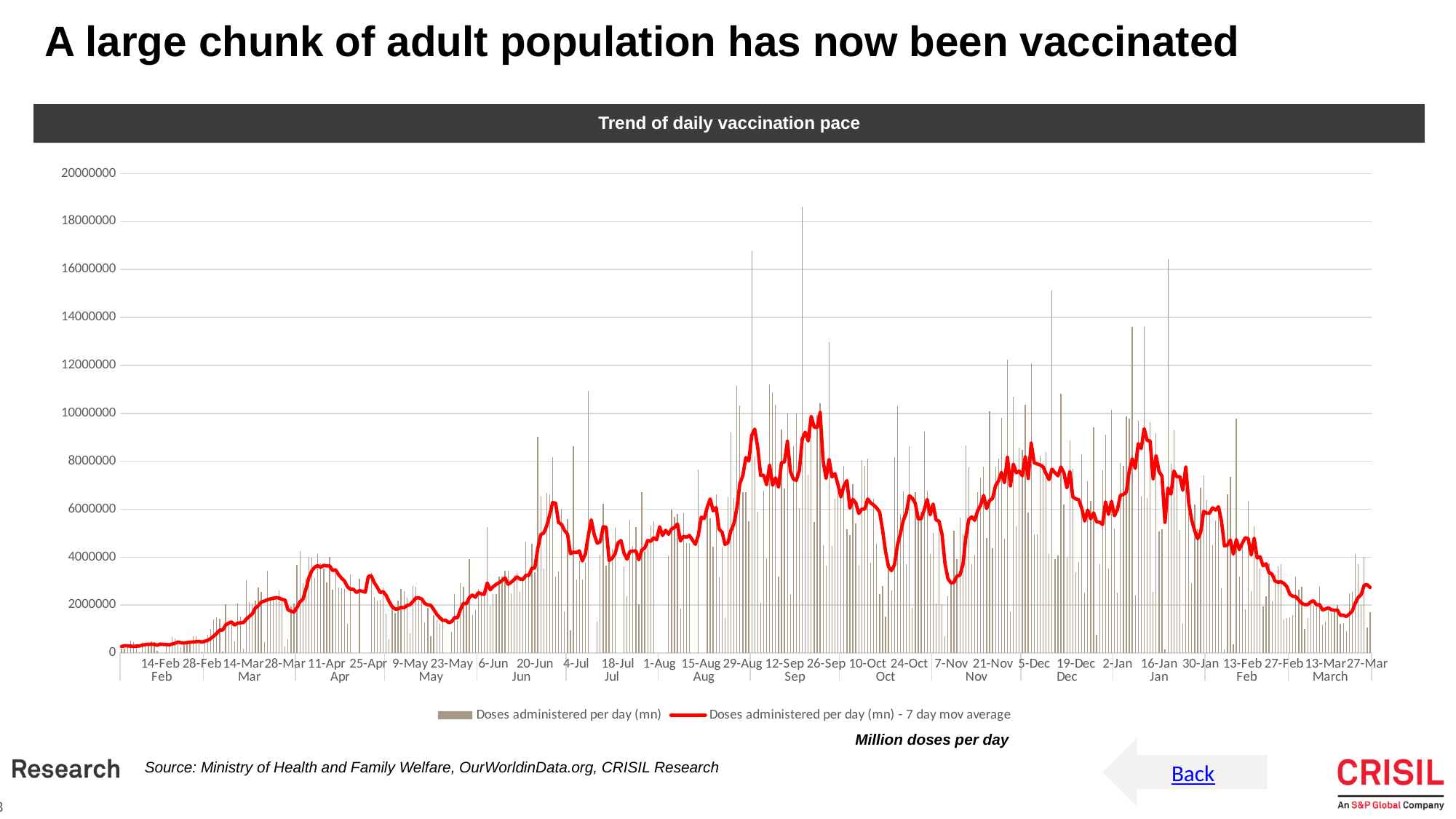
Is the 7 day moving average of doses administered per day around 14-Feb (at the start of the chart) greater or less than 2000000? less Is the tallest single-day bar for doses administered per day greater or less than 16000000? greater In which month does the tallest single-day bar for doses administered per day occur? Sep Is the 7 day moving average of doses administered per day around 7-Nov greater or less than 4000000? less What is the title of the chart on the slide? Trend of daily vaccination pace What is the highest value shown on the chart's vertical axis? 20000000 Does the 7 day moving average of doses administered per day rise or fall between 14-Feb and 11-Apr? rise Which series is drawn as a red line in the chart? Doses administered per day (mn) - 7 day mov average Does the 7 day moving average of doses administered per day rise or fall between 16-Jan and 13-Mar? fall How many series does the chart's legend list? 2 What kind of chart is shown on the slide? A combination bar and line chart